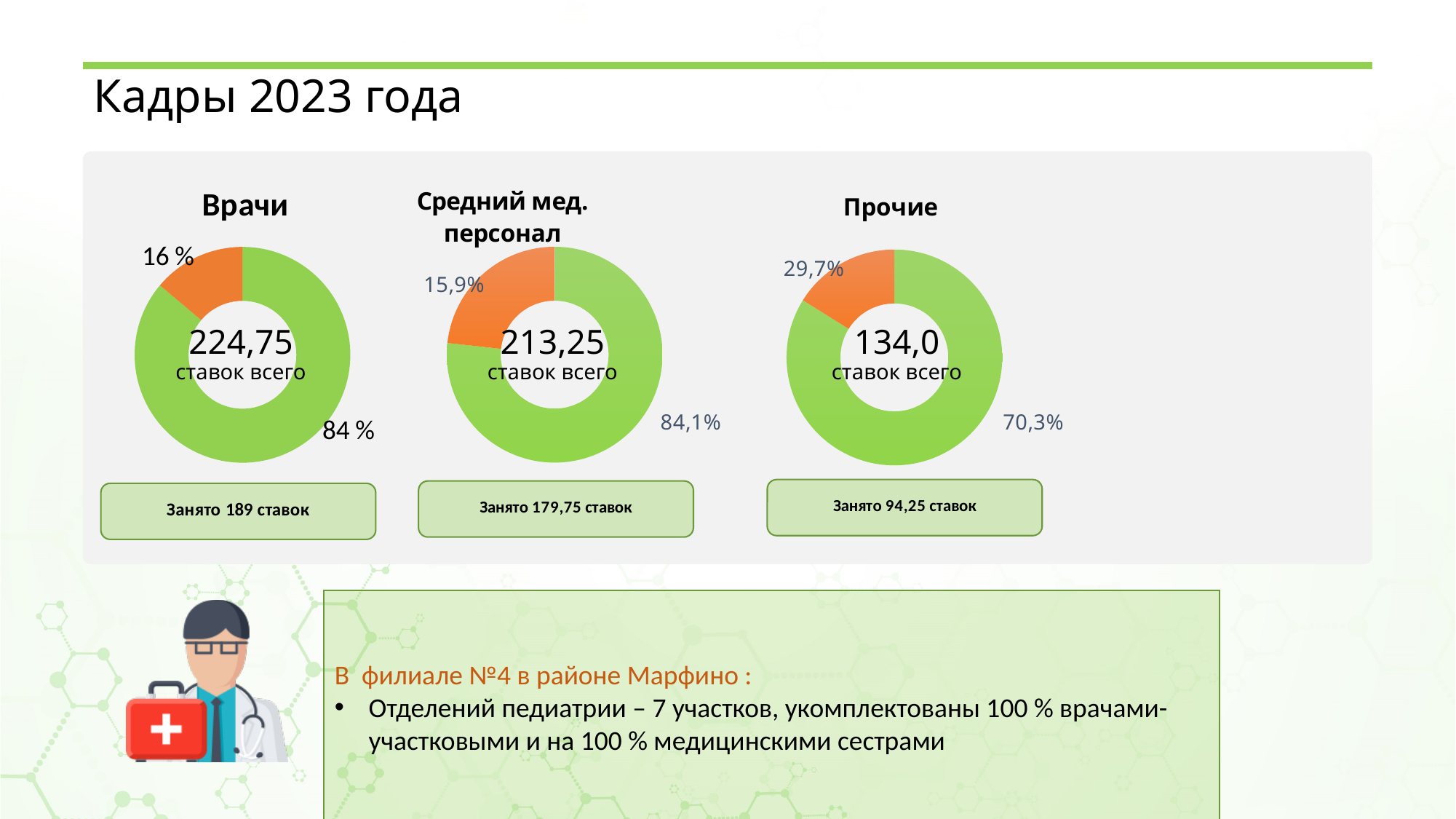
In the "Прочие" chart, what is the difference in percentage points between the green and orange segments? 40,6 What total number of positions (ставок всего) is shown in the centre of the "Средний мед. персонал" chart? 213,25 In the "Врачи" chart, what percentage is shown for the orange segment? 16 % In the "Врачи" chart, what percentage is shown for the green segment? 84 % How many segments does the "Прочие" donut chart have? 2 What total number of positions (ставок всего) is shown in the centre of the "Прочие" chart? 134,0 How many donut charts are shown on the slide? 3 What kind of chart is used for "Врачи"? Donut (pie) chart In the "Прочие" chart, what percentage is shown for the green segment? 70,3% In the "Средний мед. персонал" chart, what percentage is shown for the orange segment? 15,9%